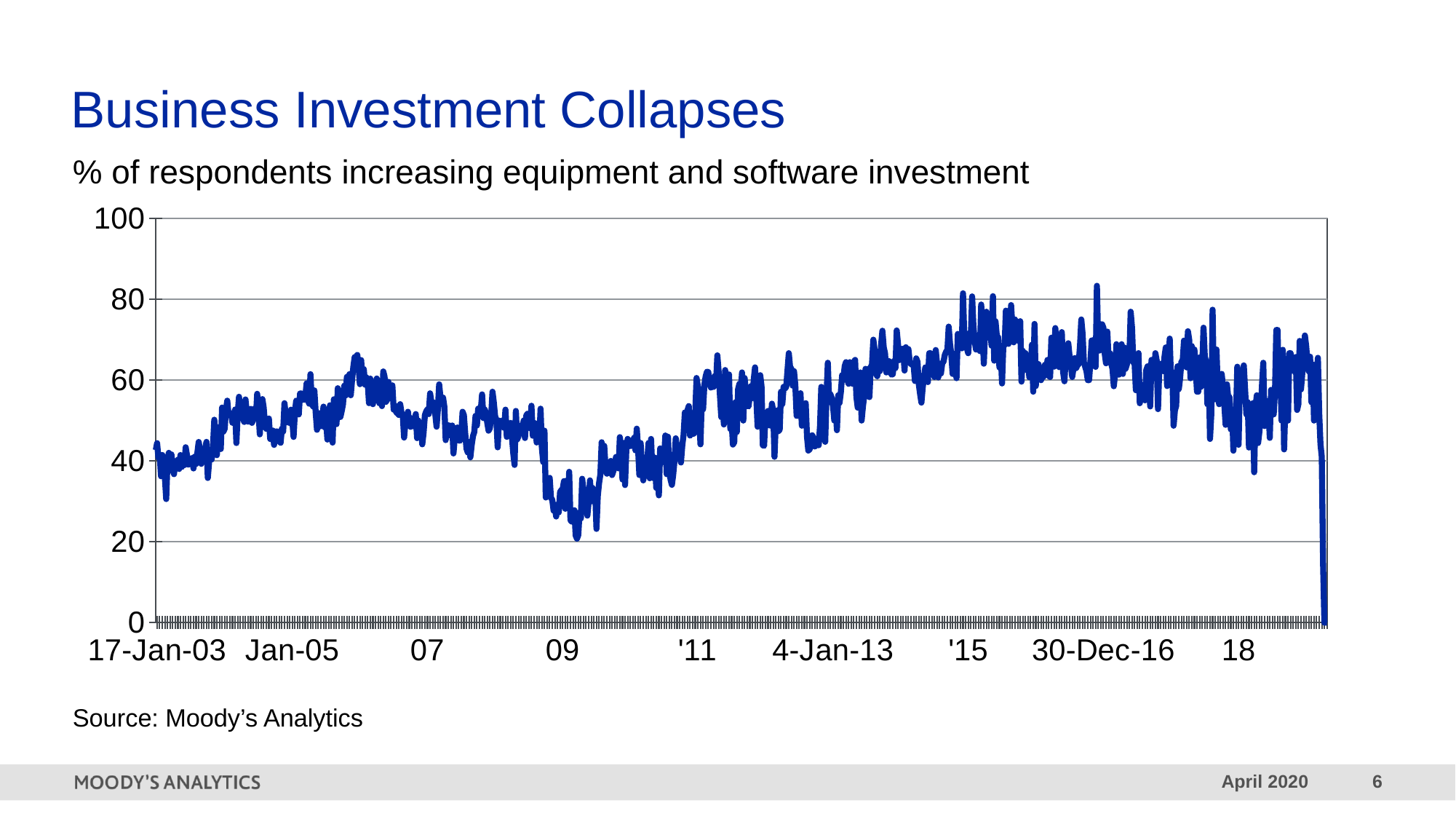
Where along the x axis does the line reach its lowest value? at the far right end (the final point) What does the line on the chart measure, according to the subtitle? % of respondents increasing equipment and software investment Does the line rise or fall sharply at the very end of the series? fall Is the value around '15 greater or less than 60? greater Do the values generally rise or fall between 09 and '15? rise What is the title of the chart on the slide? Business Investment Collapses What is the highest value shown on the vertical axis? 100 Is the value around Jan-05 greater or less than 40? greater Is the value around early 2009 greater or less than 40? less What kind of chart is shown on the slide? line chart How many lines (series) are plotted on the chart? 1